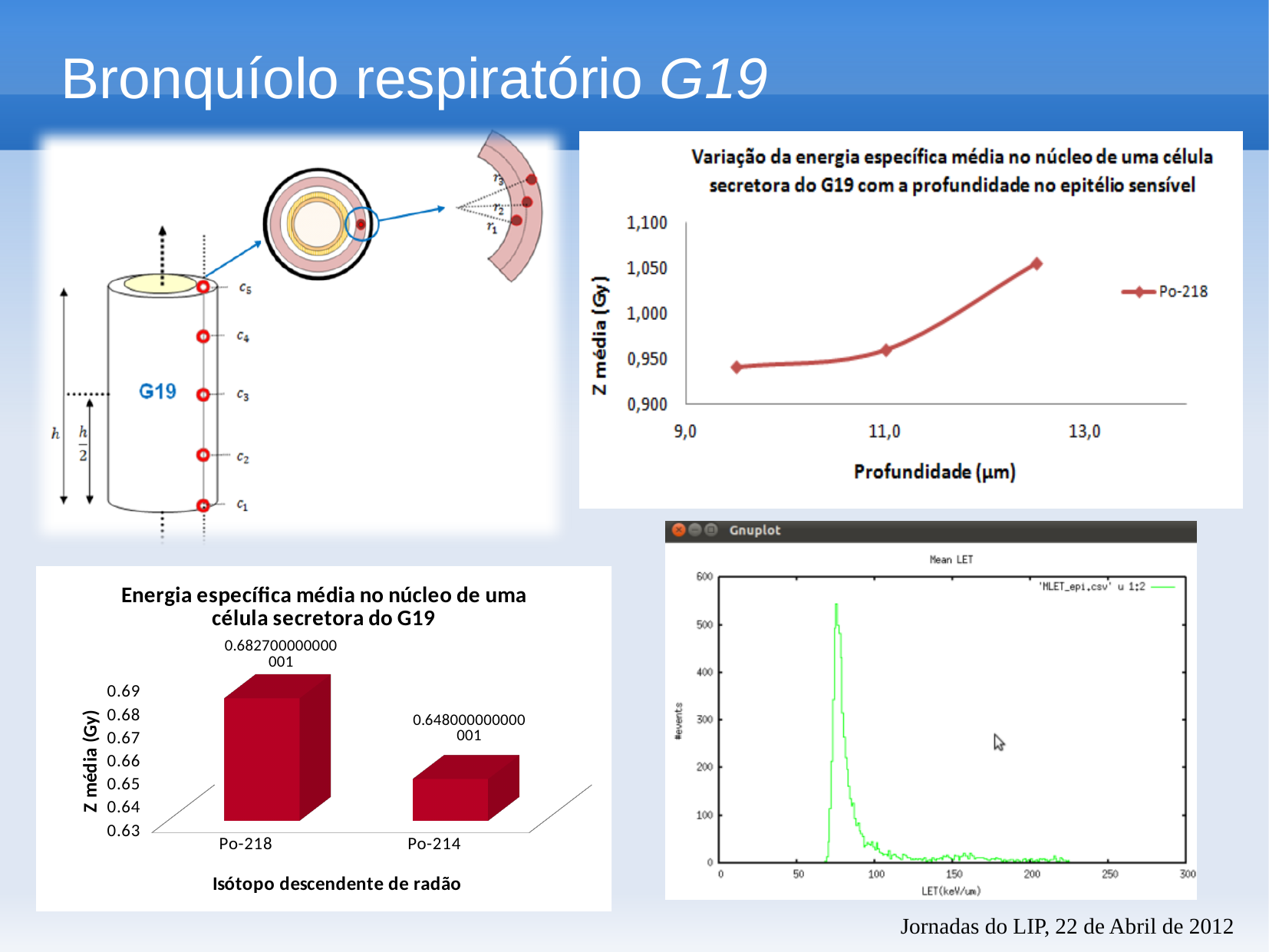
In the bar chart at the bottom left, which isotope has the higher Z média? Po-218 How many categories are shown in the bar chart at the bottom left? 2 In the line chart at the top right, is the value of the first (leftmost) point greater or less than 0,950? less In the Gnuplot chart at the bottom right, is the peak number of events greater or less than 500? greater What kind of chart is the one at the bottom left of the slide? Bar chart In the bar chart titled 'Energia específica média no núcleo de uma célula secretora do G19', what is the value for Po-214? 0.648000000000001 In the bar chart at the bottom left, what is the difference between the values for Po-218 and Po-214? 0.0347 In the bar chart titled 'Energia específica média no núcleo de uma célula secretora do G19', what is the value for Po-218? 0.682700000000001 How many data points are plotted in the line chart at the top right? 3 In the line chart at the top right, how many series does the legend list? 1 In the line chart at the top right, does Z média rise or fall as Profundidade increases? Rises In the line chart at the top right, is the value of the last (rightmost) point greater or less than 1,000? greater